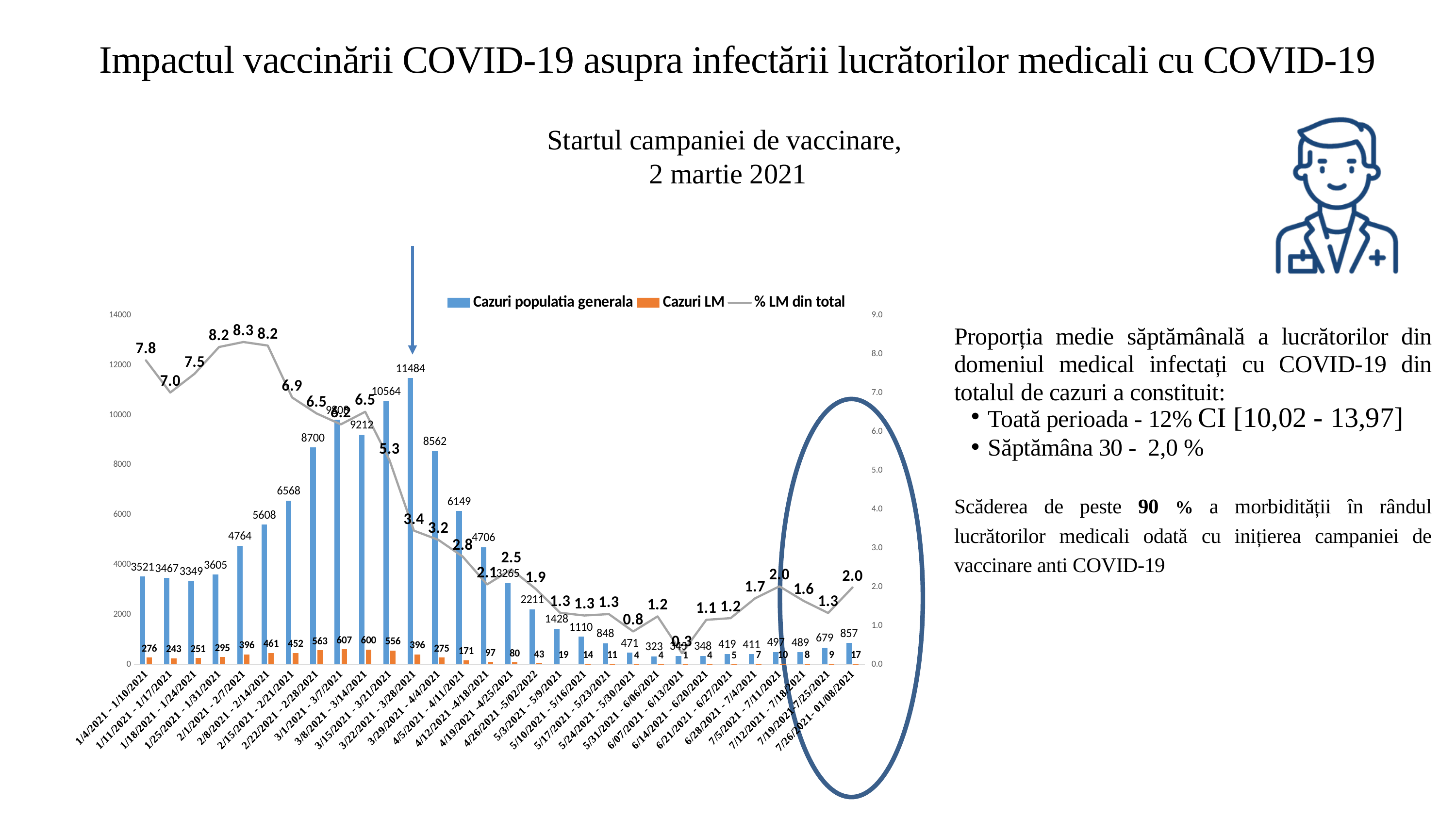
Is the value of Cazuri populatia generala for 2/15/2021 - 2/21/2021 greater or less than 6000? greater What kind of chart is shown on the slide? Combined bar and line chart What is the difference between Cazuri populatia generala for 3/22/2021 - 3/28/2021 and for 3/29/2021 - 4/4/2021? 2922 What is the value of Cazuri populatia generala for the week 3/22/2021 - 3/28/2021? 11484 Which week has the lowest % LM din total value? 6/07/2021 - 6/13/2021 What is the value of Cazuri LM for the week 3/1/2021 - 3/7/2021? 607 What is the value of Cazuri LM for the last week, 7/26/2021 - 01/08/2021? 17 Which is larger, Cazuri LM for 2/22/2021 - 2/28/2021 or for 3/15/2021 - 3/21/2021? 2/22/2021 - 2/28/2021 What is the % LM din total value for the week 2/1/2021 - 2/7/2021? 8.3 Which week has the highest value of Cazuri populatia generala? 3/22/2021 - 3/28/2021 How does the % LM din total line change from 3/22/2021 - 3/28/2021 to 6/07/2021 - 6/13/2021? It falls How many series does the chart legend list? 3